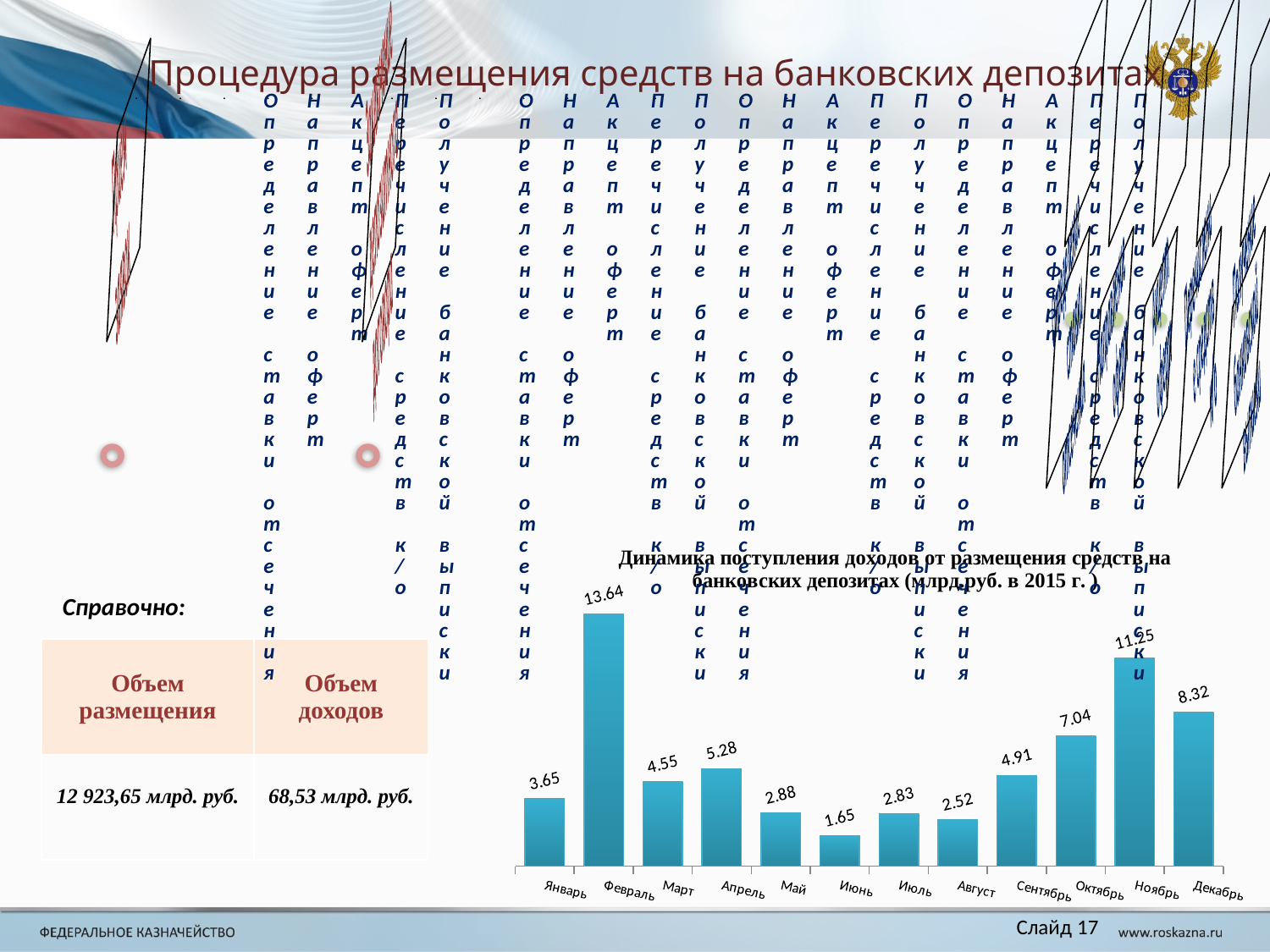
Which is larger, the value for Апрель or the value for Март? Апрель What is the value for Октябрь in the chart? 7.04 What is the difference between the values for Февраль and Январь? 9.99 Which month has the lowest value in the chart? Июнь What is the value for Февраль in the chart? 13.64 What is the value for Июнь in the chart? 1.65 What is the value for Декабрь in the chart? 8.32 How many months (categories) are shown in the chart? 12 Which month has the highest value in the chart? Февраль What type of chart is shown on the slide? bar chart What is the title of the chart? Динамика поступления доходов от размещения средств на банковских депозитах (млрд.руб. в 2015 г.) What is the difference between the values for Декабрь and Сентябрь? 3.41